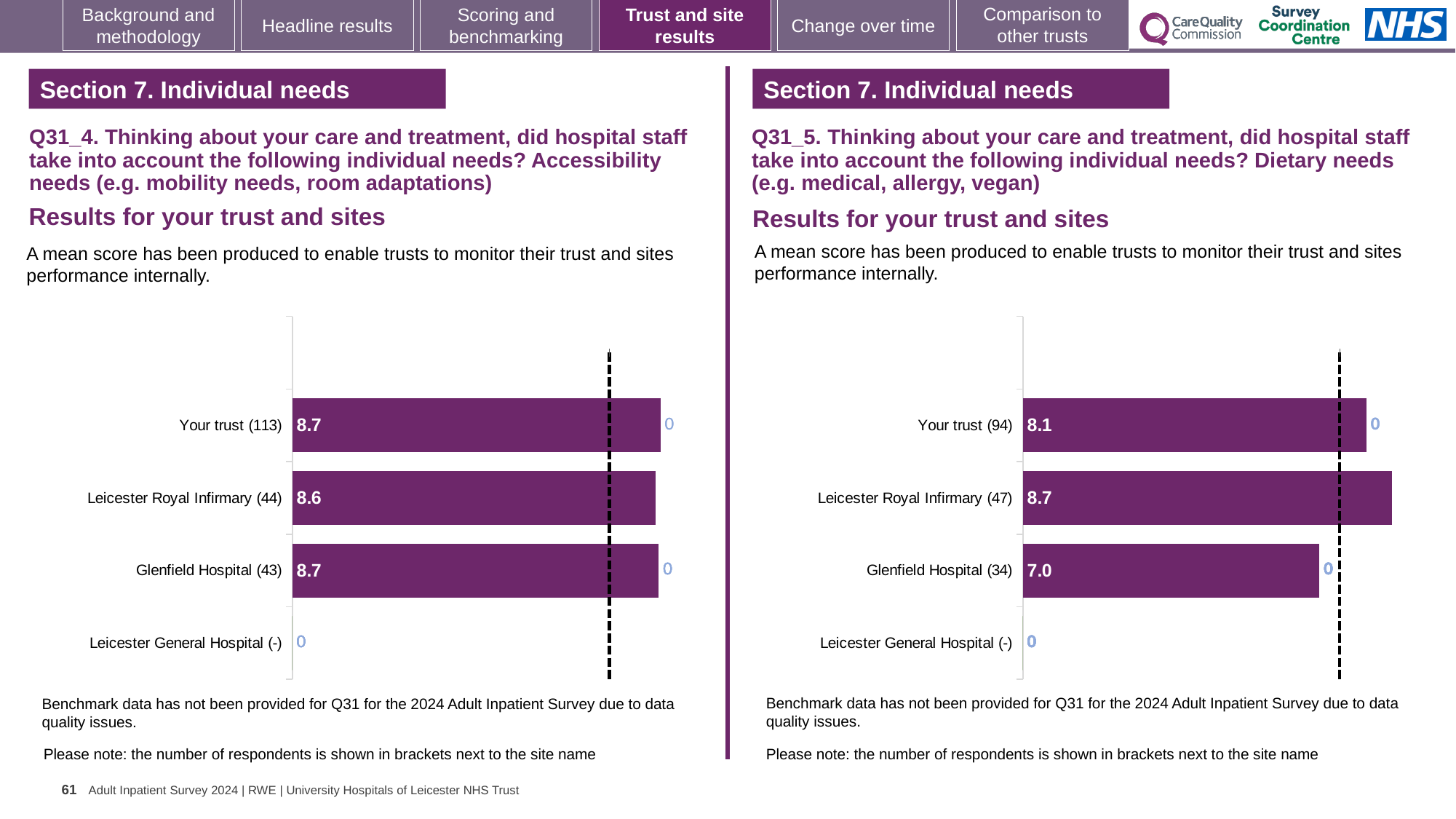
In the Q31_4 Accessibility needs chart on the left, what is the mean score for Your trust? 8.7 In the Q31_4 Accessibility needs chart on the left, what is the mean score for Glenfield Hospital? 8.7 In the Q31_5 Dietary needs chart on the right, which site has the highest mean score? Leicester Royal Infirmary In the Q31_5 Dietary needs chart on the right, which is larger: the mean score for Your trust or for Leicester Royal Infirmary? Leicester Royal Infirmary What kind of chart is used for the Q31_5 Dietary needs results on the right? Bar chart How many categories are listed on the y axis of the Q31_4 Accessibility needs chart on the left? 4 In the Q31_5 Dietary needs chart on the right, which of the named sites with a score has the lowest mean score? Glenfield Hospital In the Q31_5 Dietary needs chart on the right, how many respondents are shown in brackets for Your trust? 94 In the Q31_4 Accessibility needs chart on the left, what is the mean score for Leicester Royal Infirmary? 8.6 In the Q31_5 Dietary needs chart on the right, what is the difference between the mean scores for Leicester Royal Infirmary and Glenfield Hospital? 1.7 In the Q31_5 Dietary needs chart on the right, what is the mean score for Your trust? 8.1 In the Q31_5 Dietary needs chart on the right, what is the mean score for Glenfield Hospital? 7.0